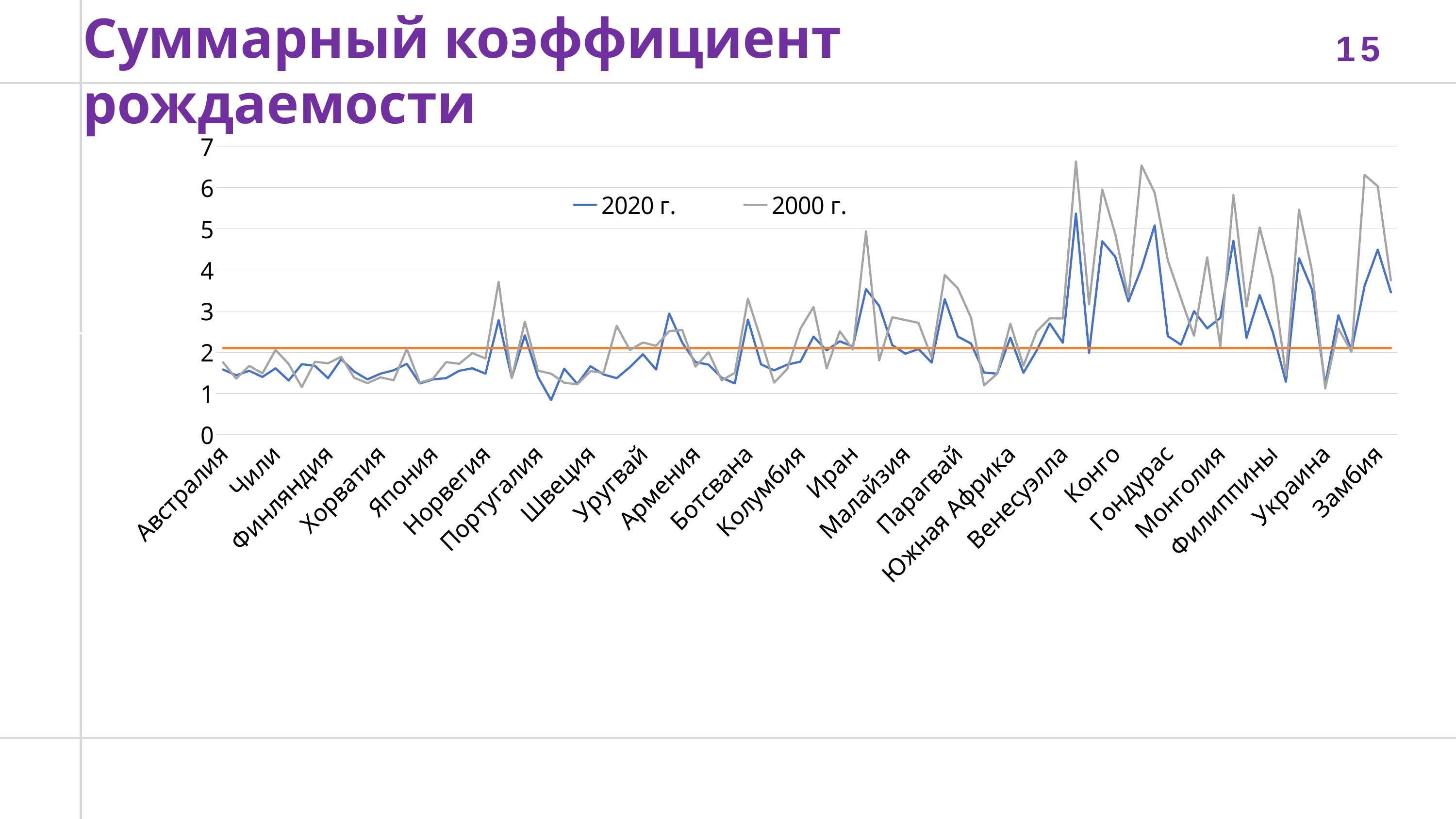
Is the lowest value of the 2020 г. series greater or less than 1? less Is the highest value of the 2020 г. series greater or less than 6? less What is the title of the slide containing the chart? Суммарный коэффициент рождаемости Do the values generally rise or fall moving from left (Австралия) to right (Замбия) along the x axis? rise What are the two series named in the chart legend? 2020 г. and 2000 г. Which series generally has higher values across the chart, 2020 г. or 2000 г.? 2000 г. Is the value for the last category, Замбия, in the 2020 г. series greater or less than 3? greater How many series does the chart legend list? 2 What kind of chart is shown on the slide? line chart